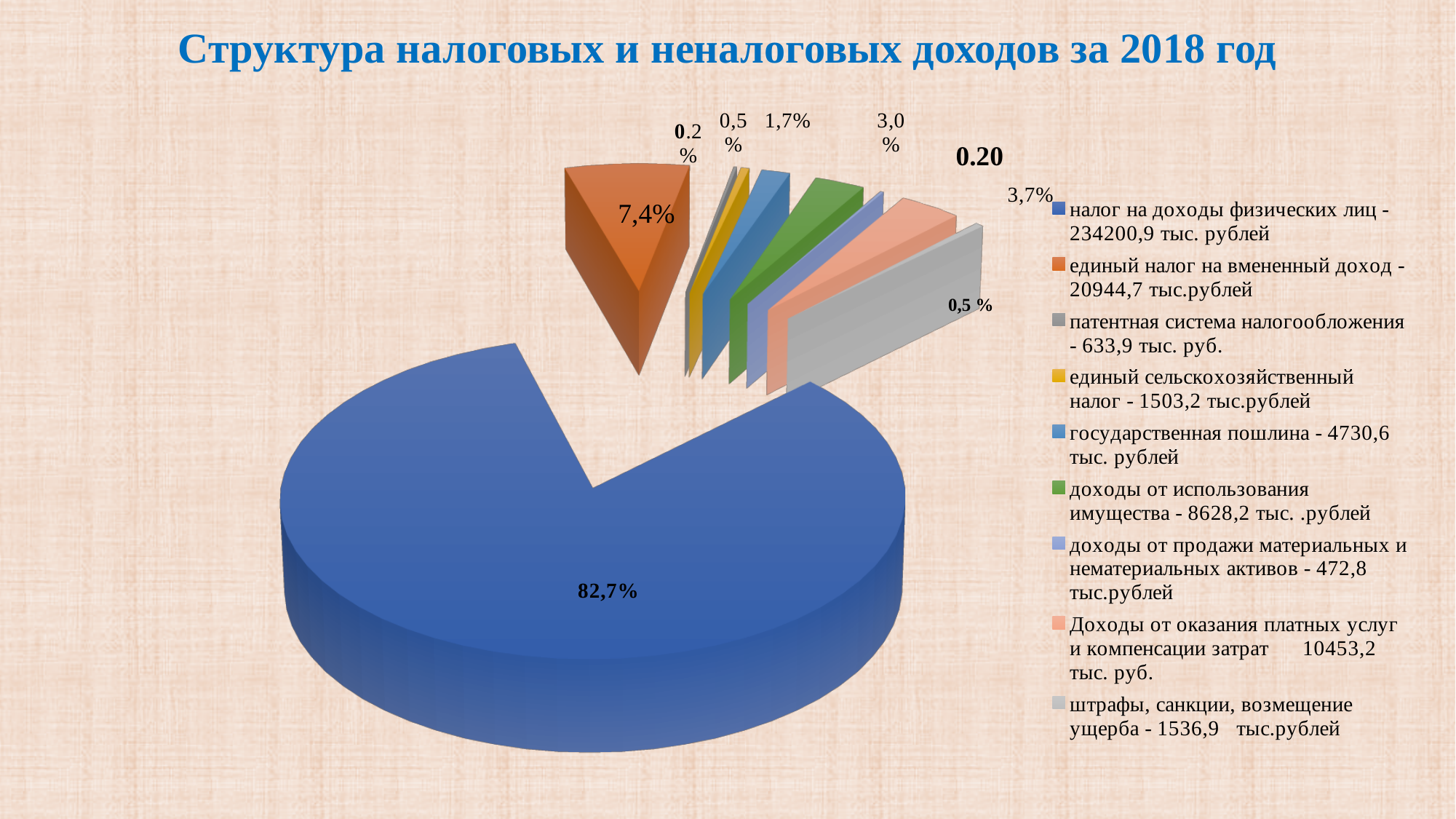
What is the title of the chart? Структура налоговых и неналоговых доходов за 2018 год What share of the pie does the orange slice (единый налог на вмененный доход) have? 7,4% According to the legend, what amount is given for штрафы, санкции, возмещение ущерба? 1536,9 тыс.рублей According to the legend, what amount is given for доходы от использования имущества? 8628,2 тыс. рублей What colour is the largest slice of the pie? Blue According to the legend, what amount is given for налог на доходы физических лиц? 234200,9 тыс. рублей Which category has the largest slice of the pie? налог на доходы физических лиц What kind of chart is shown on the slide? Pie chart How many categories does the legend of the pie chart list? 9 Which is larger: the slice for налог на доходы физических лиц or the slice for единый налог на вмененный доход? налог на доходы физических лиц According to the legend, what amount is given for государственная пошлина? 4730,6 тыс. рублей What share of the pie does the largest slice (налог на доходы физических лиц) have? 82,7%